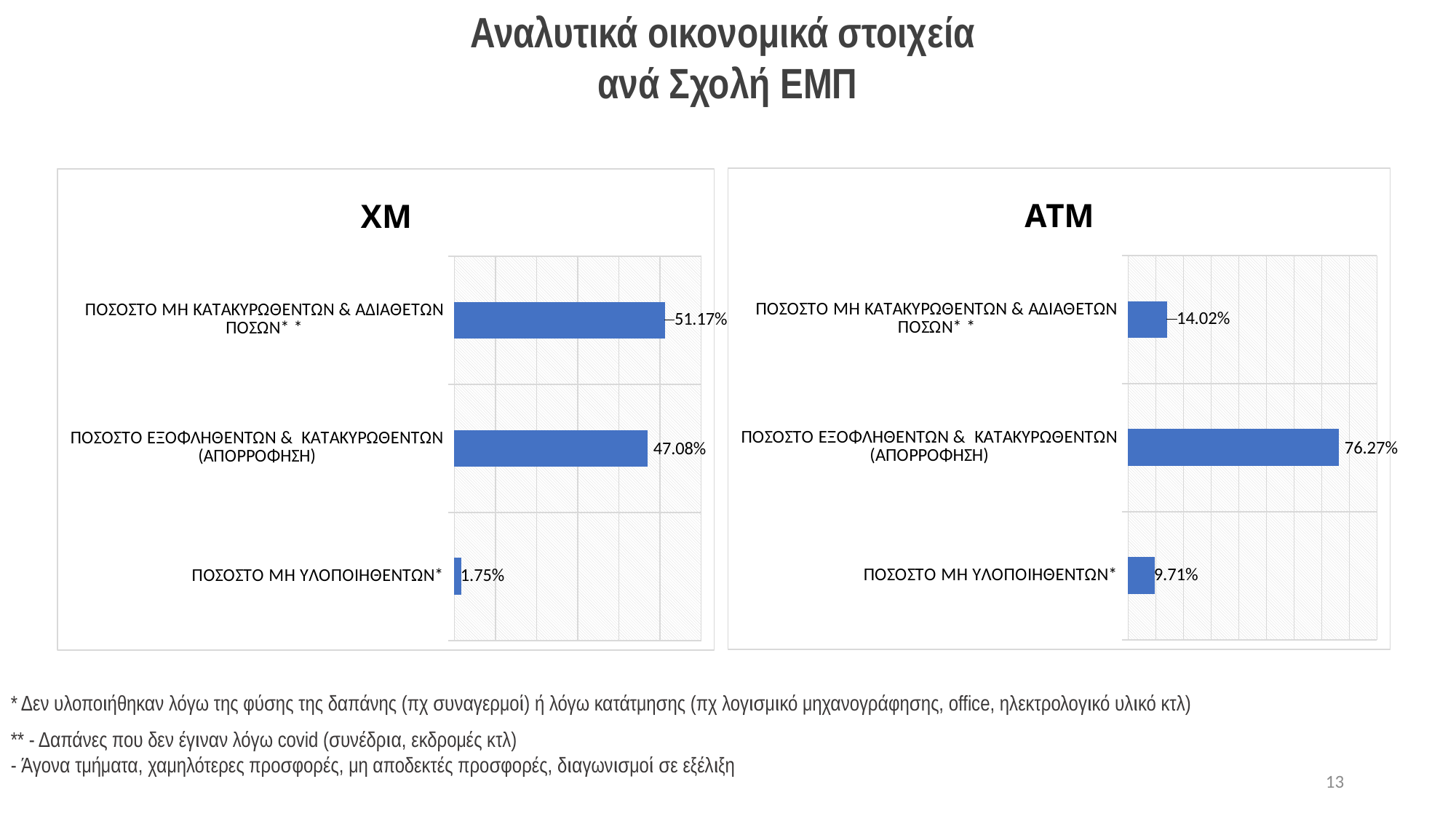
In the ΧΜ chart, what is the value for ΠΟΣΟΣΤΟ ΜΗ ΚΑΤΑΚΥΡΩΘΕΝΤΩΝ & ΑΔΙΑΘΕΤΩΝ ΠΟΣΩΝ? 51.17% In the ΧΜ chart, which category has the highest value? ΠΟΣΟΣΤΟ ΜΗ ΚΑΤΑΚΥΡΩΘΕΝΤΩΝ & ΑΔΙΑΘΕΤΩΝ ΠΟΣΩΝ In the ΑΤΜ chart, which category has the lowest value? ΠΟΣΟΣΤΟ ΜΗ ΥΛΟΠΟΙΗΘΕΝΤΩΝ What type of chart is the ΧΜ chart? Bar chart In the ΧΜ chart, what is the difference between ΠΟΣΟΣΤΟ ΜΗ ΚΑΤΑΚΥΡΩΘΕΝΤΩΝ & ΑΔΙΑΘΕΤΩΝ ΠΟΣΩΝ and ΠΟΣΟΣΤΟ ΕΞΟΦΛΗΘΕΝΤΩΝ & ΚΑΤΑΚΥΡΩΘΕΝΤΩΝ (ΑΠΟΡΡΟΦΗΣΗ)? 4.09% In the ΑΤΜ chart, what is the value for ΠΟΣΟΣΤΟ ΕΞΟΦΛΗΘΕΝΤΩΝ & ΚΑΤΑΚΥΡΩΘΕΝΤΩΝ (ΑΠΟΡΡΟΦΗΣΗ)? 76.27% In the ΧΜ chart, what is the value for ΠΟΣΟΣΤΟ ΜΗ ΥΛΟΠΟΙΗΘΕΝΤΩΝ? 1.75% In the ΑΤΜ chart, which category has the highest value? ΠΟΣΟΣΤΟ ΕΞΟΦΛΗΘΕΝΤΩΝ & ΚΑΤΑΚΥΡΩΘΕΝΤΩΝ (ΑΠΟΡΡΟΦΗΣΗ) In the ΑΤΜ chart, what is the difference between ΠΟΣΟΣΤΟ ΕΞΟΦΛΗΘΕΝΤΩΝ & ΚΑΤΑΚΥΡΩΘΕΝΤΩΝ (ΑΠΟΡΡΟΦΗΣΗ) and ΠΟΣΟΣΤΟ ΜΗ ΚΑΤΑΚΥΡΩΘΕΝΤΩΝ & ΑΔΙΑΘΕΤΩΝ ΠΟΣΩΝ? 62.25% In the ΑΤΜ chart, what is the value for ΠΟΣΟΣΤΟ ΜΗ ΥΛΟΠΟΙΗΘΕΝΤΩΝ? 9.71% Which chart has the larger value for ΠΟΣΟΣΤΟ ΜΗ ΚΑΤΑΚΥΡΩΘΕΝΤΩΝ & ΑΔΙΑΘΕΤΩΝ ΠΟΣΩΝ, ΧΜ or ΑΤΜ? ΧΜ How many categories are shown in the ΑΤΜ chart? 3